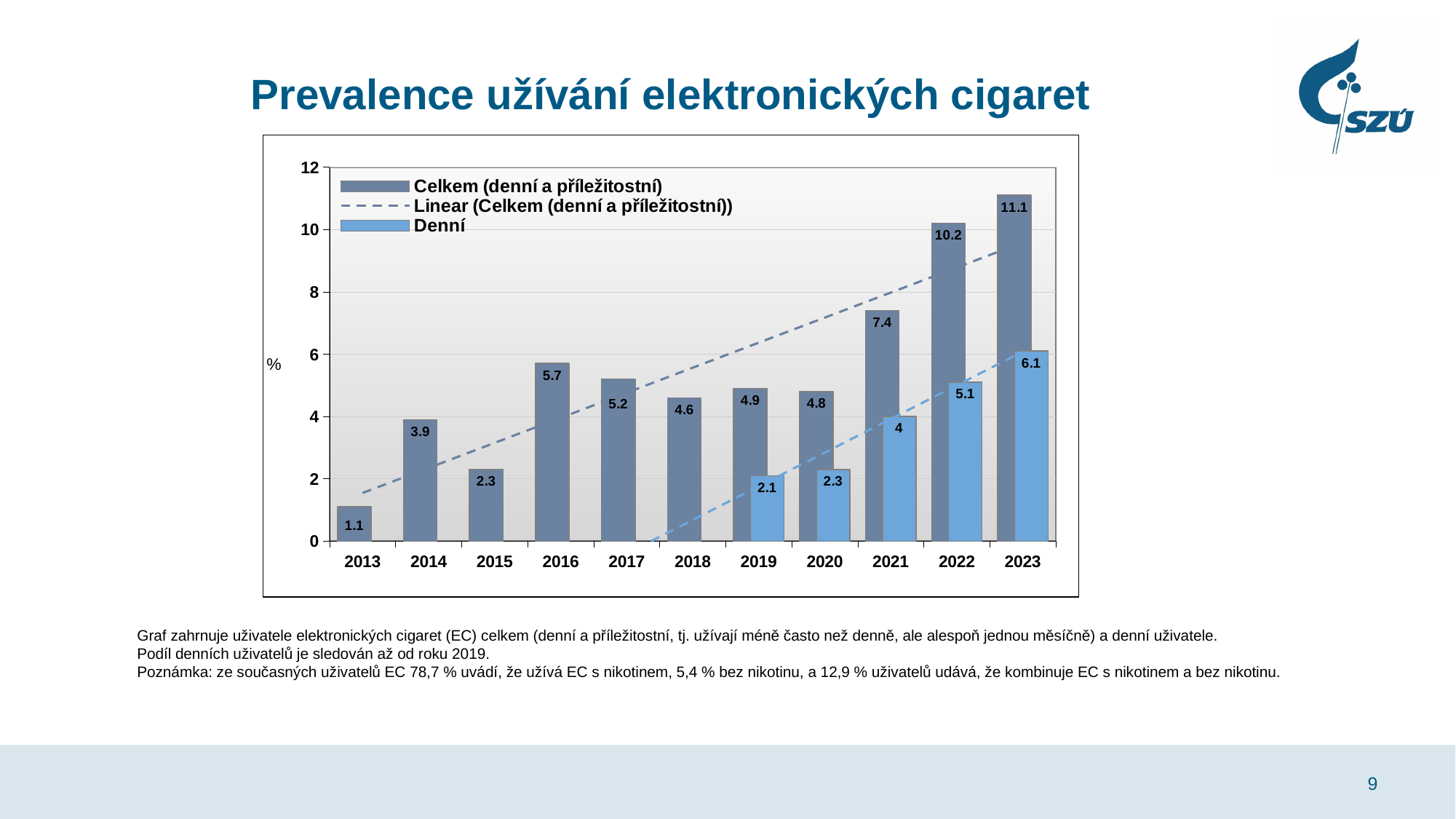
Is the 'Celkem (denní a příležitostní)' value for 2021 greater or less than 6? greater How many years are shown on the x axis? 11 What is the value of 'Celkem (denní a příležitostní)' for 2023? 11.1 What is the value of 'Denní' for 2021? 4 What is the value of 'Celkem (denní a příležitostní)' for 2016? 5.7 What is the difference between the 'Celkem (denní a příležitostní)' value and the 'Denní' value in 2022? 5.1 Which year has the highest value for 'Celkem (denní a příležitostní)'? 2023 Which is larger: the 'Celkem (denní a příležitostní)' value for 2017 or for 2018? 2017 What kind of chart is shown on the slide? bar chart Do the 'Denní' values rise or fall from 2019 to 2023? rise How many entries does the legend list? 3 Which year has the lowest value for 'Celkem (denní a příležitostní)'? 2013